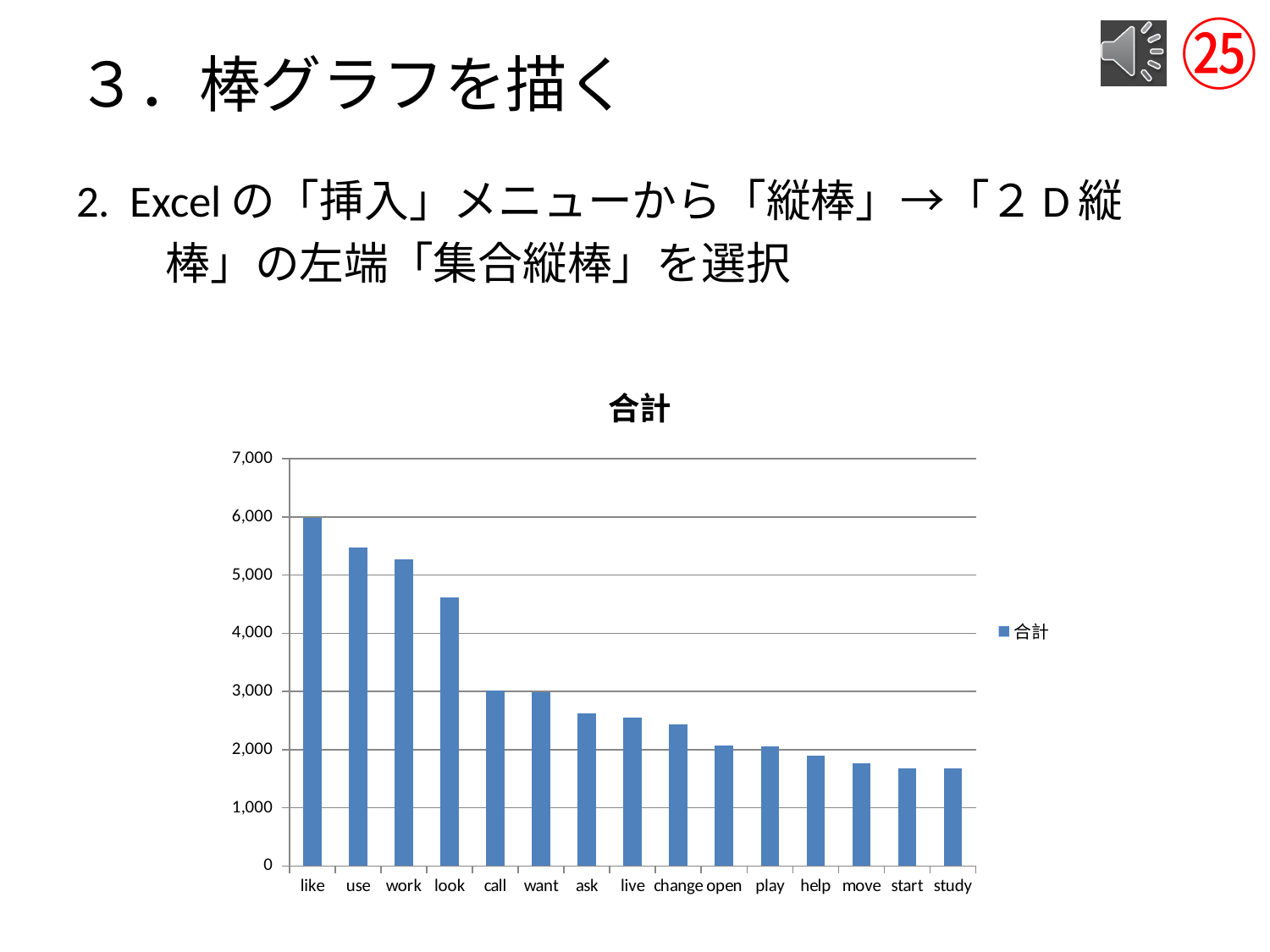
How many categories are plotted along the x axis of the chart? 15 What kind of chart is shown on the slide? bar chart Is the value for help greater or less than 2,000? less Do the values rise or fall moving from left to right along the x axis? fall What is the title of the chart? 合計 Which has a larger value, like or use? like Is the value for like greater or less than 5,000? greater Which has a larger value, look or call? look Is the value for ask greater or less than 3,000? less How many series does the chart legend list? 1 Which category has the highest value in the chart? like